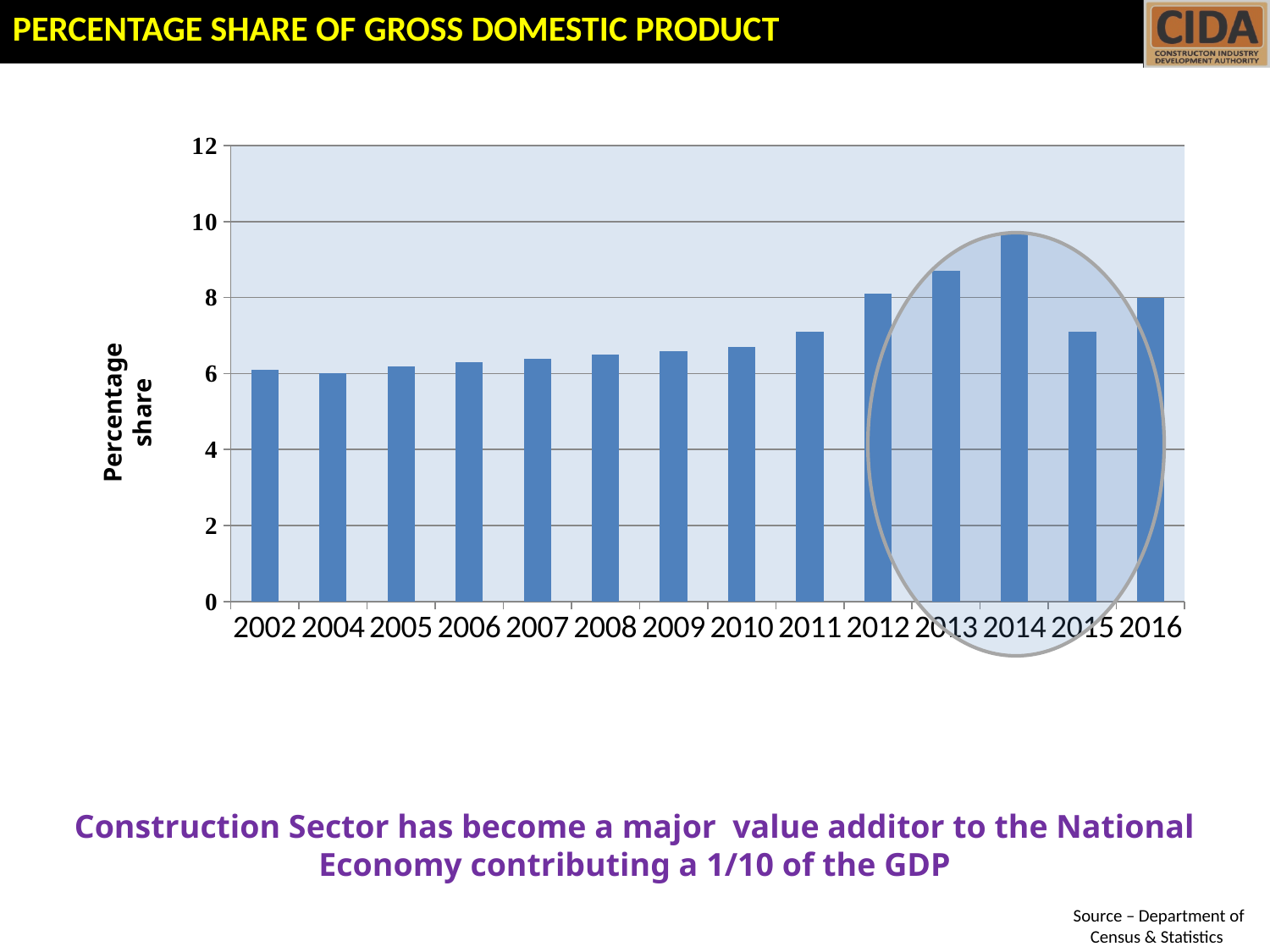
What kind of chart is shown on the slide? bar chart Is the value for 2002 greater or less than 8? less Is the value for 2013 greater or less than 8? greater How many years (bars) are plotted in the chart? 14 Do the values generally rise or fall from 2002 to 2014? rise Is the value for 2015 greater or less than 8? less What is the label on the vertical axis of the chart? Percentage share Which is larger, the value for 2011 or the value for 2012? 2012 Which is larger, the value for 2013 or the value for 2014? 2014 Which year has the highest percentage share of GDP? 2014